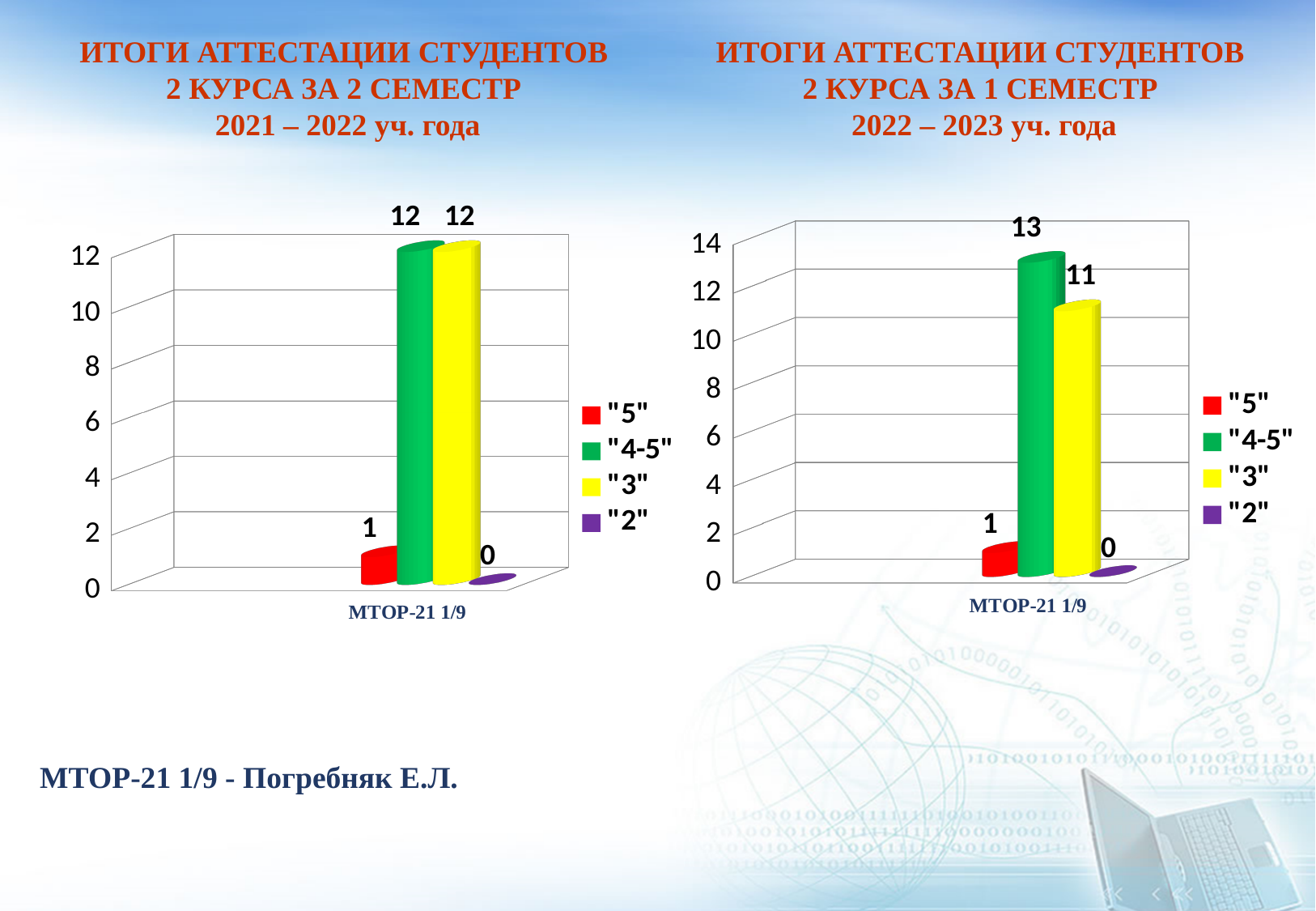
In the left chart (2 семестр 2021 – 2022), what is the value for the "4-5" series for МТОР-21 1/9? 12 How many series does the legend of the left chart (2 семестр 2021 – 2022) list? 4 In the right chart (1 семестр 2022 – 2023), which is larger, the "4-5" value or the "3" value? "4-5" What is the category label on the x axis of the left chart (2 семестр 2021 – 2022)? МТОР-21 1/9 In the right chart (1 семестр 2022 – 2023), what is the value for the "3" series? 11 What kind of chart is the right chart (1 семестр 2022 – 2023)? Bar chart In the right chart (1 семестр 2022 – 2023), which series has the highest value? "4-5" In the left chart (2 семестр 2021 – 2022), which series has the lowest value? "2" In the right chart (1 семестр 2022 – 2023), what is the difference between the "4-5" value and the "3" value? 2 In the right chart (1 семестр 2022 – 2023), what is the value for the "4-5" series? 13 In the right chart (1 семестр 2022 – 2023), what colour is the bar for the "3" series? Yellow In the left chart (2 семестр 2021 – 2022), what is the value for the "5" series? 1